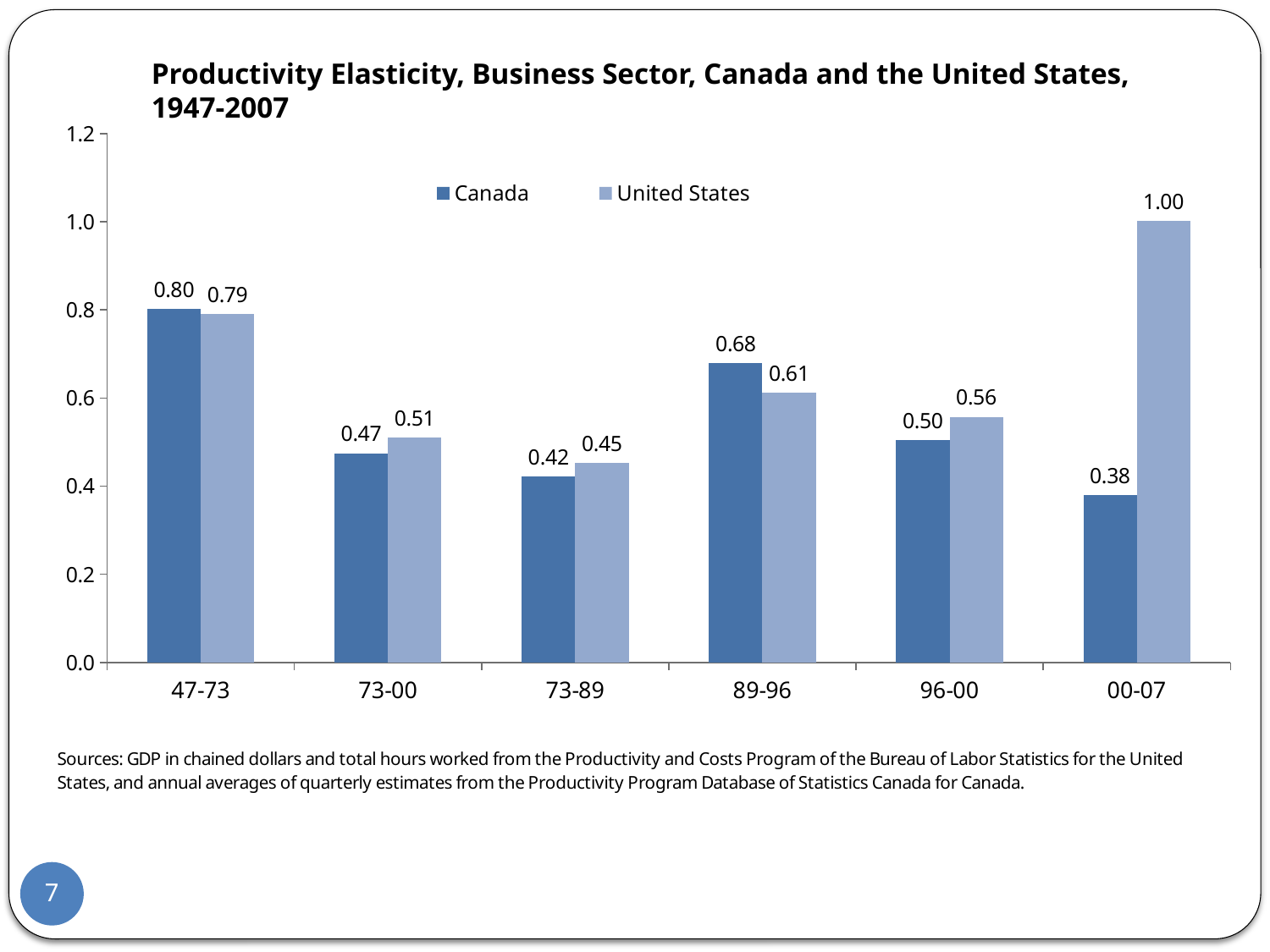
How many periods are shown on the x axis? 6 How many series does the legend list? 2 What is the value for the United States in the 73-00 period? 0.51 In the 89-96 period, which is larger, the Canada value or the United States value? Canada Which period has the lowest value for Canada? 00-07 What is the value for Canada in the 47-73 period? 0.80 What kind of chart is shown on the slide? Bar chart What is the value for Canada in the 89-96 period? 0.68 What is the difference between the United States and Canada values in the 00-07 period? 0.62 What is the title of the chart? Productivity Elasticity, Business Sector, Canada and the United States, 1947-2007 Which period has the highest value for the United States? 00-07 What is the value for the United States in the 00-07 period? 1.00